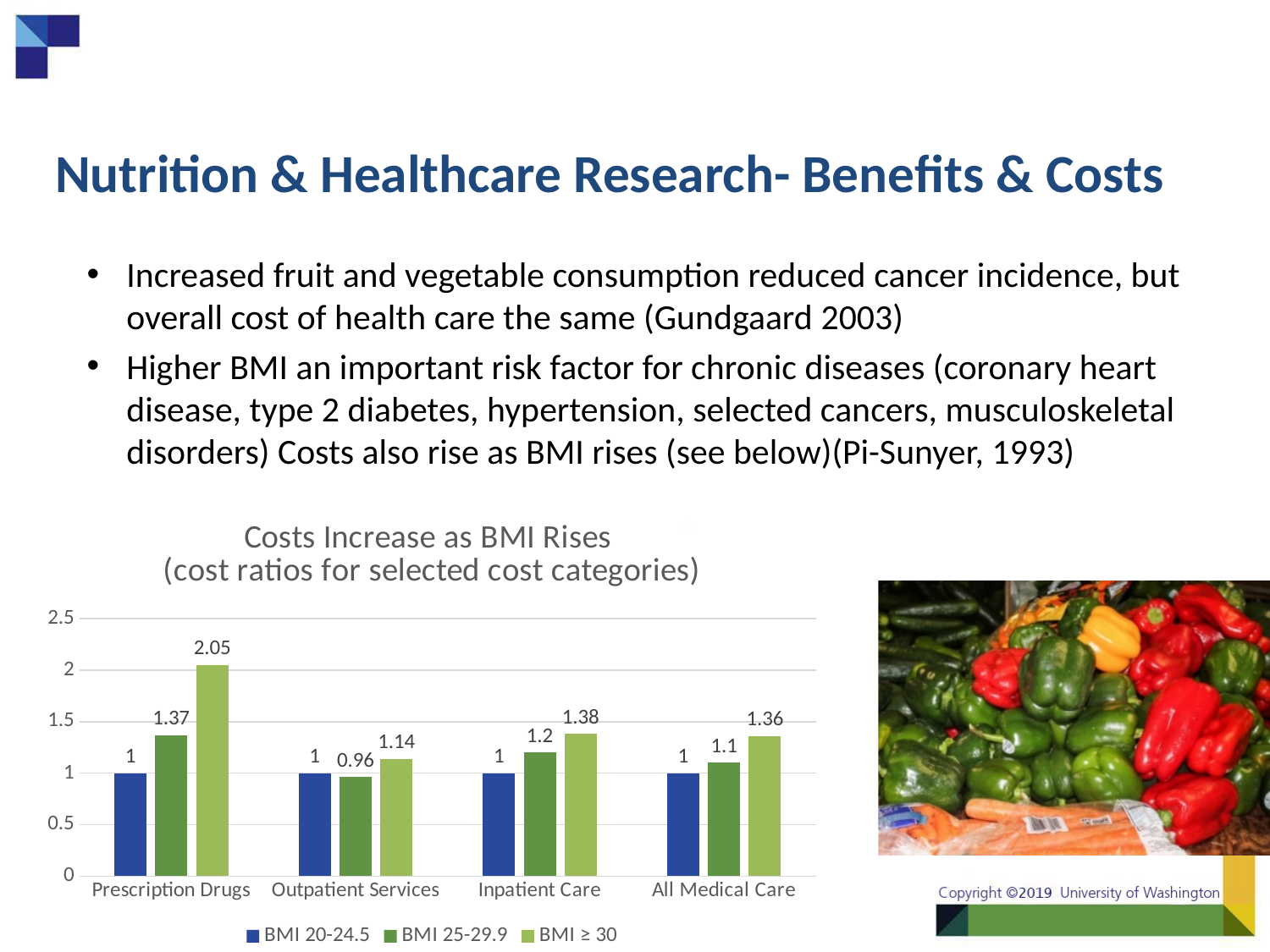
What is the title of the chart? Costs Increase as BMI Rises (cost ratios for selected cost categories) Which cost category has the lowest cost ratio for BMI 25-29.9? Outpatient Services What is the cost ratio for BMI ≥ 30 in the All Medical Care category? 1.36 What is the cost ratio for BMI 25-29.9 in the Outpatient Services category? 0.96 Which cost category has the highest cost ratio for BMI ≥ 30? Prescription Drugs What is the cost ratio for BMI ≥ 30 in the Prescription Drugs category? 2.05 How many cost categories are shown on the x axis of the chart? 4 What is the cost ratio for BMI 25-29.9 in the Inpatient Care category? 1.2 Which is larger: the BMI ≥ 30 cost ratio for Inpatient Care or for All Medical Care? Inpatient Care How many series does the chart legend list? 3 What kind of chart is shown on the slide? Bar chart What is the difference between the BMI ≥ 30 and BMI 20-24.5 cost ratios for Prescription Drugs? 1.05